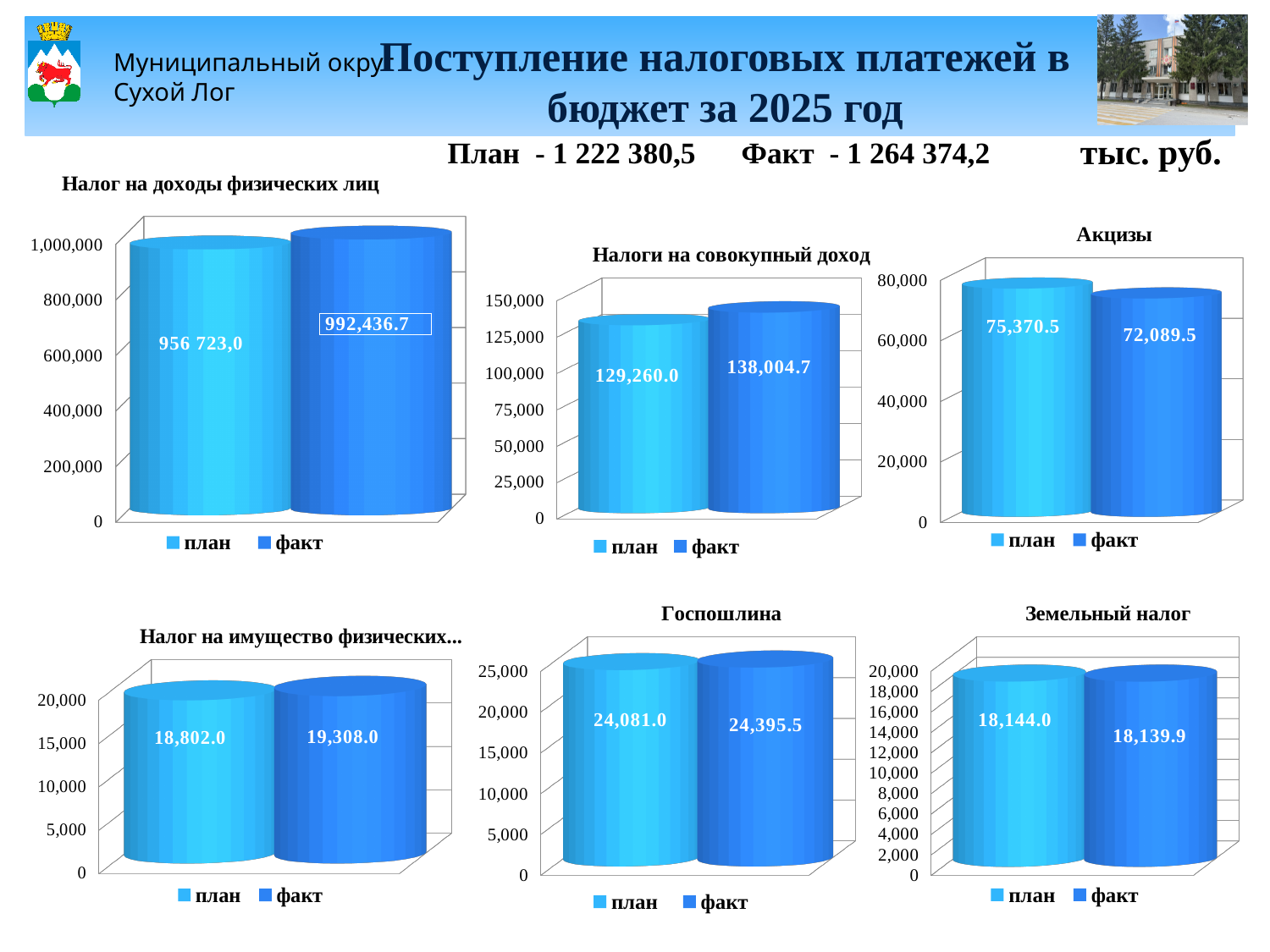
In the chart titled 'Акцизы', which is larger, план or факт? план In the chart titled 'Налоги на совокупный доход', is the value for план greater or less than 125,000? greater In the chart titled 'Налог на доходы физических лиц', what is the value for факт? 992,436.7 In the chart titled 'Госпошлина', what is the difference between факт and план? 314.5 In the chart titled 'Налог на доходы физических лиц', what is the value for план? 956 723,0 In the chart titled 'Налоги на совокупный доход', what is the value for факт? 138,004.7 In the chart titled 'Акцизы', what is the difference between план and факт? 3,281.0 In the chart titled 'Акцизы', what is the value for план? 75,370.5 In the chart titled 'Налог на имущество физических...', what is the value for план? 18,802.0 What kind of chart is the chart titled 'Акцизы'? bar chart How many series does the legend of the chart titled 'Госпошлина' list? 2 In the chart titled 'Земельный налог', what is the value for факт? 18,139.9